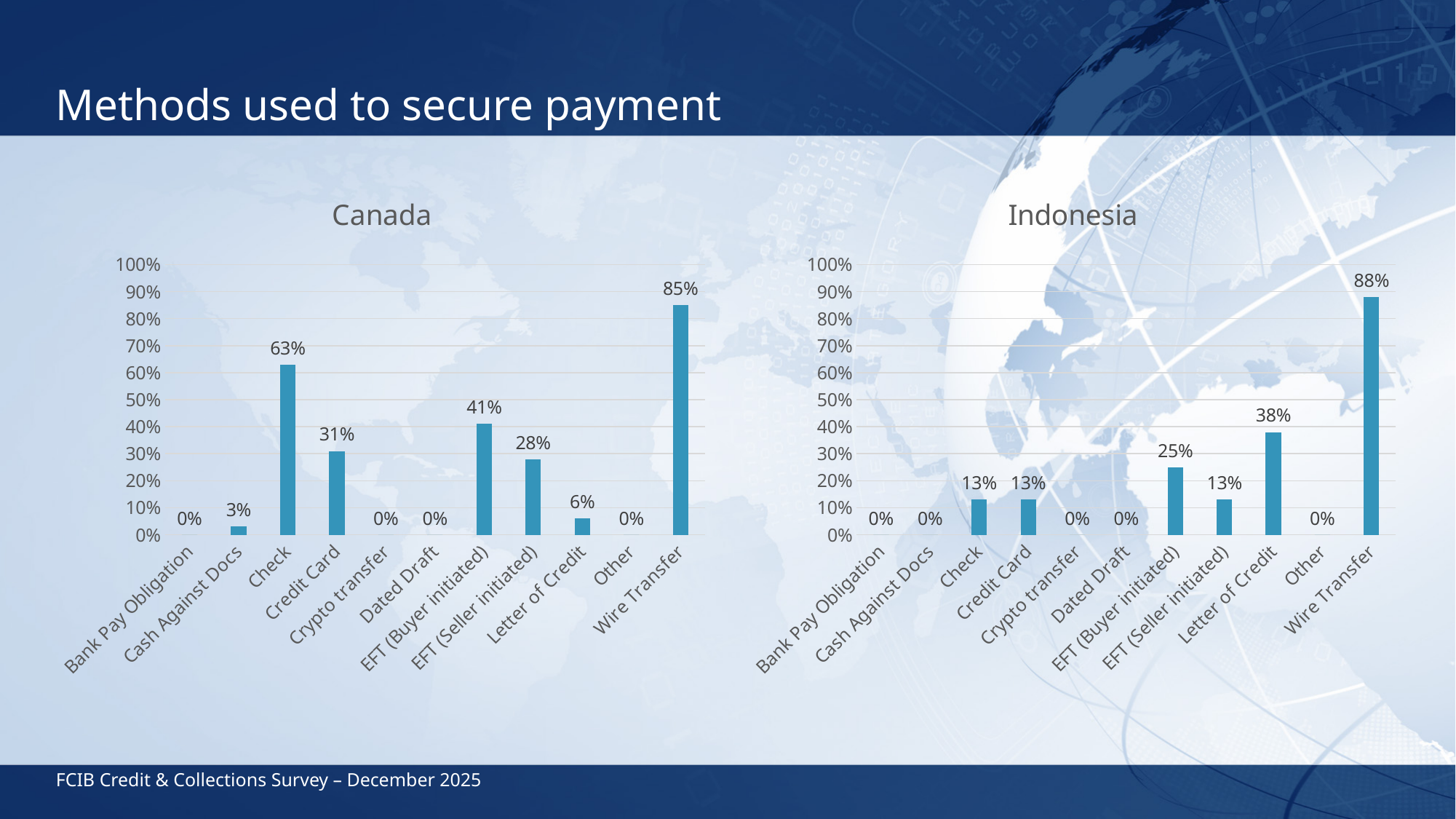
In the Canada chart, which category has the highest value? Wire Transfer In the Indonesia chart, what is the value for Letter of Credit? 38% In the Canada chart, what is the value for Letter of Credit? 6% In the Indonesia chart, what is the value for EFT (Buyer initiated)? 25% Which chart shows a higher value for Wire Transfer, Canada or Indonesia? Indonesia In the Canada chart, what is the value for Check? 63% In the Canada chart, which is larger: EFT (Buyer initiated) or EFT (Seller initiated)? EFT (Buyer initiated) In the Canada chart, how many categories are shown on the x axis? 11 In the Indonesia chart, what is the difference between Wire Transfer and Letter of Credit? 50% What kind of chart is the Indonesia chart? Bar chart In the Canada chart, what is the difference between Wire Transfer and Check? 22% In the Indonesia chart, which category has the highest value? Wire Transfer